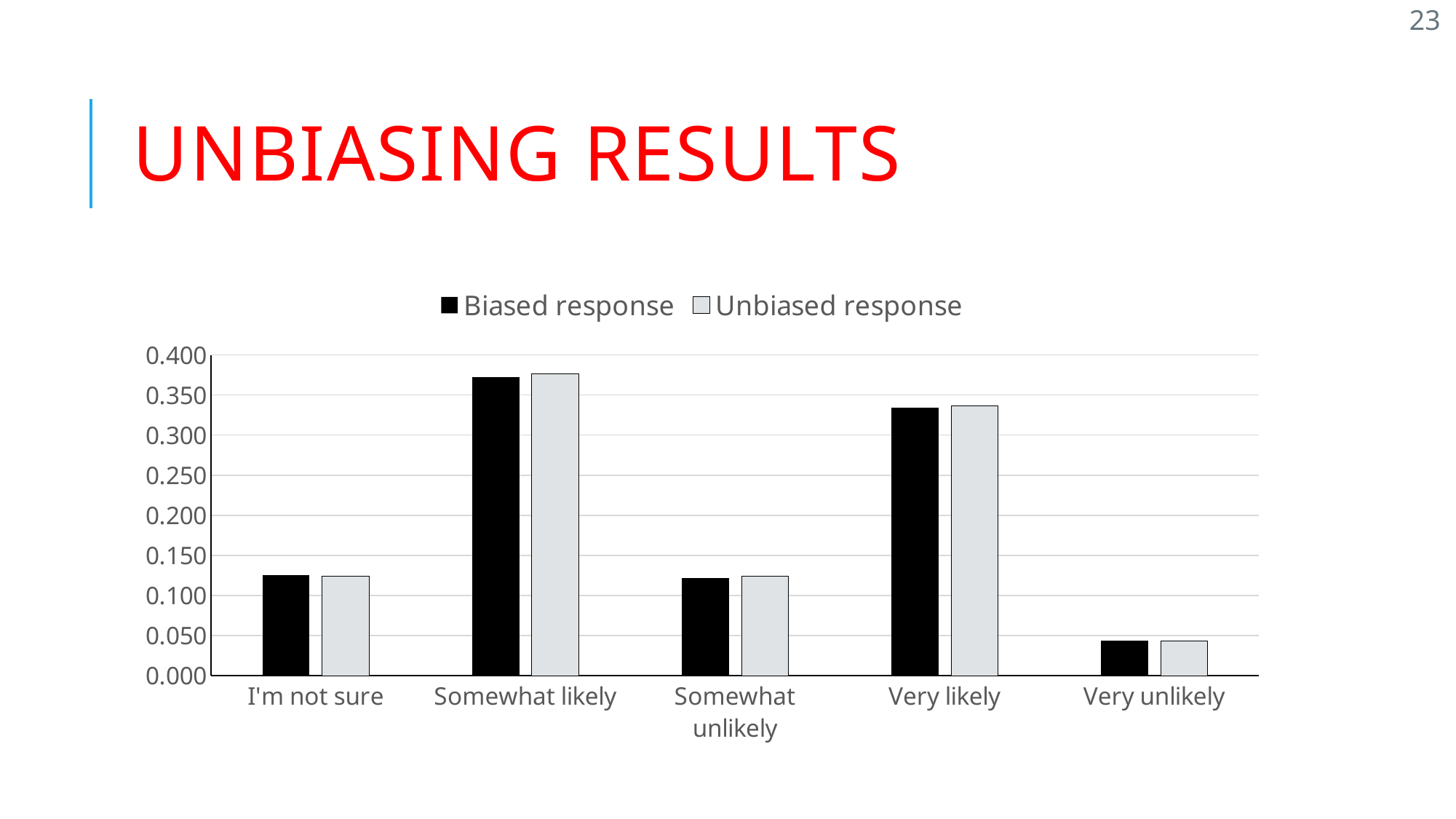
What kind of chart is shown on the slide? Bar chart Which is larger for the Unbiased response series: I'm not sure or Very unlikely? I'm not sure Which is larger for the Biased response series: Somewhat likely or Very likely? Somewhat likely Is the Biased response value for Very likely greater or less than 0.350? less Which category has the highest Biased response value? Somewhat likely Which category has the lowest Unbiased response value? Very unlikely What are the two series named in the legend? Biased response and Unbiased response Is the Biased response value for Somewhat likely greater or less than 0.350? greater How many categories are shown on the x axis? 5 Is the Unbiased response value for Very unlikely greater or less than 0.050? less How many series does the legend list? 2